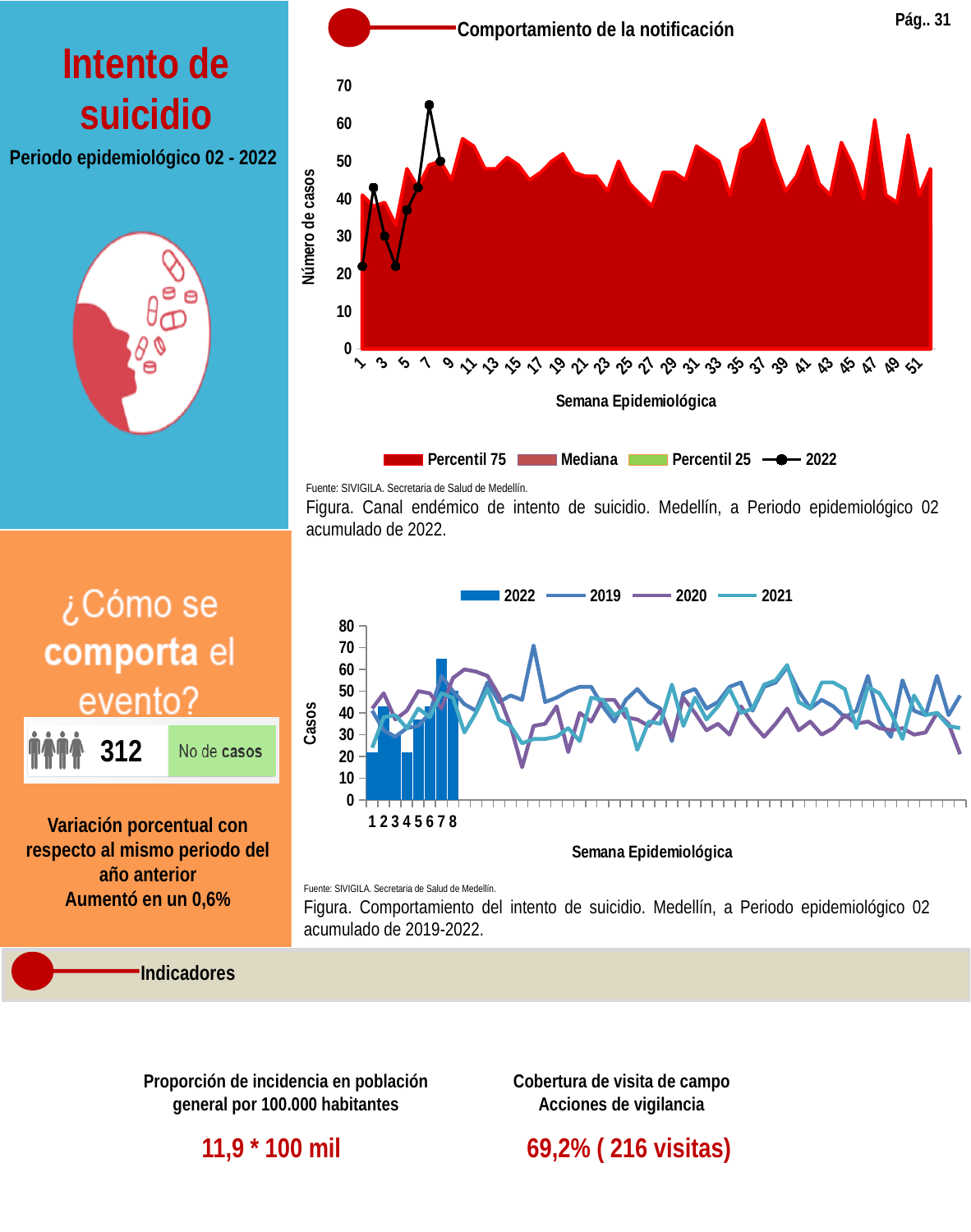
In the bottom chart (Comportamiento del intento de suicidio 2019-2022), how many bars are plotted for the 2022 series? 8 In the top chart 'Comportamiento de la notificación', which legend entry is drawn as a black line with markers? 2022 In the bottom chart (Comportamiento del intento de suicidio 2019-2022), is the 2022 bar at week 7 greater or less than 60? greater In the bottom chart (Comportamiento del intento de suicidio 2019-2022), how many series does the legend list? 4 In the bottom chart (Comportamiento del intento de suicidio 2019-2022), is the 2022 bar at week 1 greater or less than 30? less In the top chart 'Comportamiento de la notificación', is the 2022 value at week 4 greater or less than 30? less In the top chart 'Comportamiento de la notificación', how many entries does the legend list? 4 In the bottom chart (Comportamiento del intento de suicidio 2019-2022), which series is plotted as bars rather than a line? 2022 In the bottom chart (Comportamiento del intento de suicidio 2019-2022), at which week is the 2022 bar highest? Week 7 In the top chart 'Comportamiento de la notificación', what is the label of the vertical axis? Número de casos